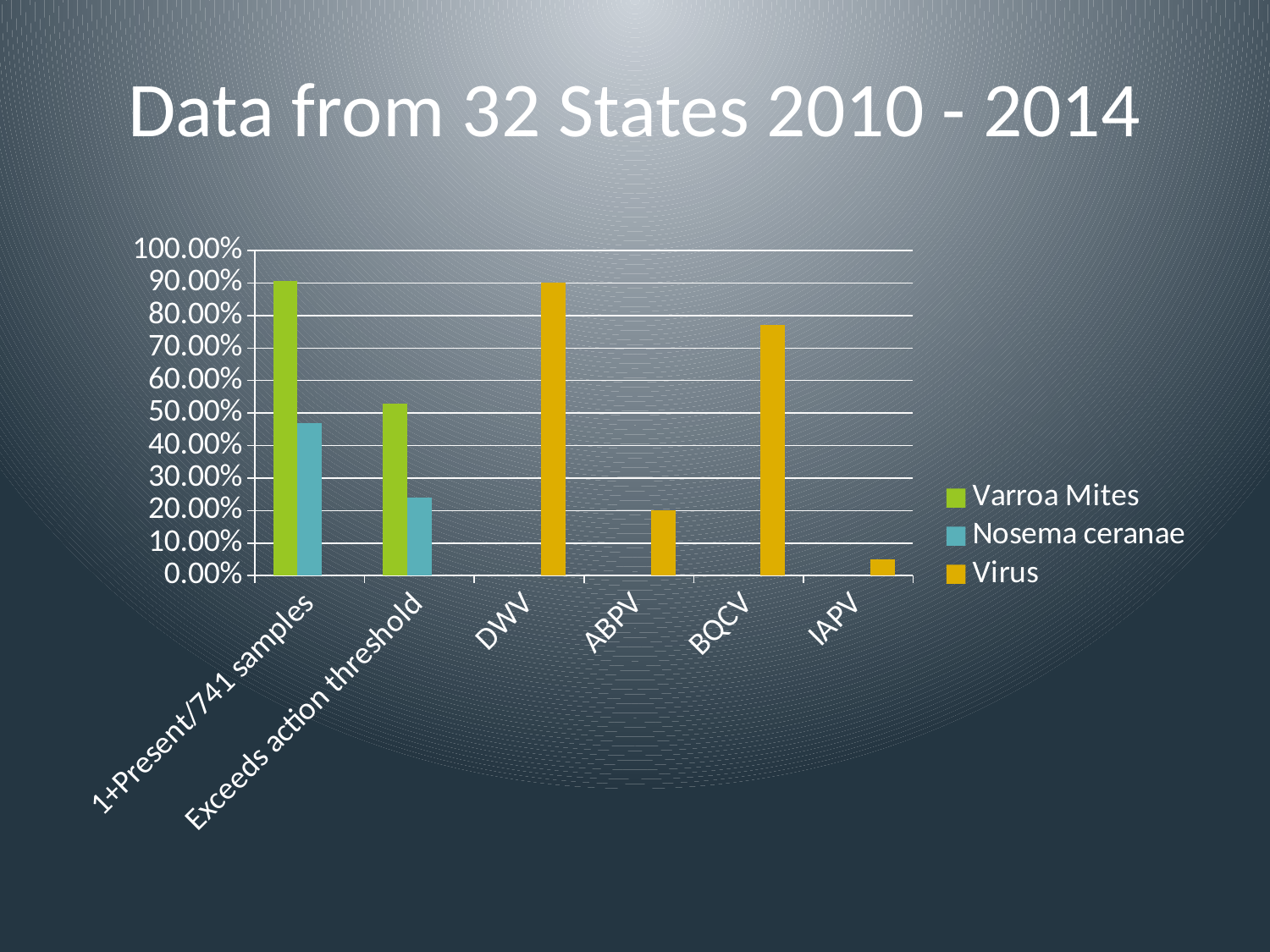
How many series does the legend list? 3 What kind of chart is shown on the slide? bar chart Is the Virus value for IAPV greater or less than 10.00%? less Is the Nosema ceranae value for Exceeds action threshold greater or less than 30.00%? less Is the Varroa Mites value for 1+Present/741 samples greater or less than 80.00%? greater Which series is shown in green? Varroa Mites Among the virus categories (DWV, ABPV, BQCV, IAPV), which has the highest value? DWV For Exceeds action threshold, which is larger: the Varroa Mites value or the Nosema ceranae value? Varroa Mites Among the virus categories (DWV, ABPV, BQCV, IAPV), which has the lowest value? IAPV How many categories are shown along the x axis? 6 What is the title of the slide? Data from 32 States 2010 - 2014